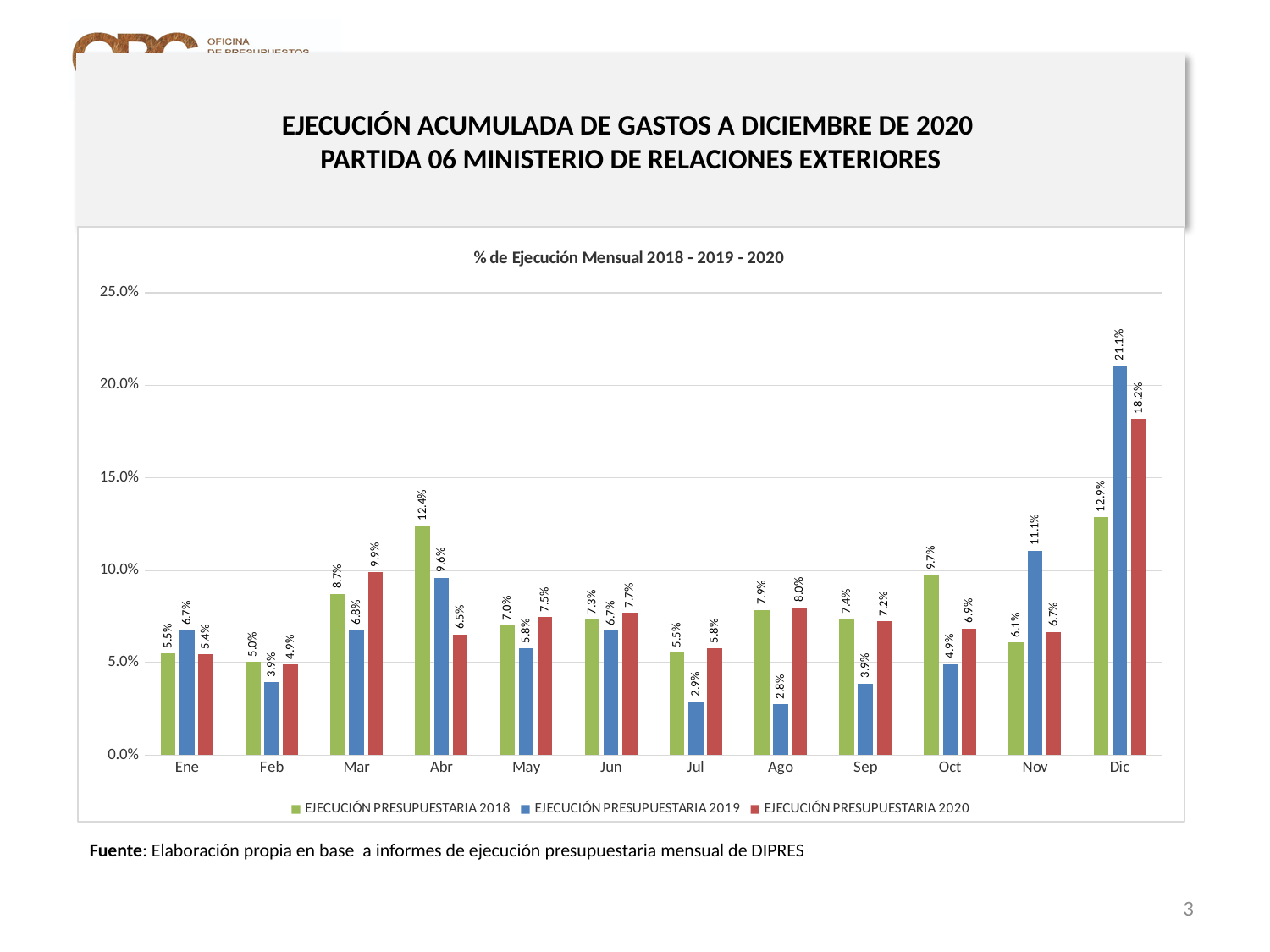
Is the value for EJECUCIÓN PRESUPUESTARIA 2018 in Oct greater or less than 5.0%? greater In Nov, which series has the larger value: EJECUCIÓN PRESUPUESTARIA 2018 or EJECUCIÓN PRESUPUESTARIA 2019? EJECUCIÓN PRESUPUESTARIA 2019 What is the value for EJECUCIÓN PRESUPUESTARIA 2018 in Abr? 12.4% What is the value for EJECUCIÓN PRESUPUESTARIA 2020 in Mar? 9.9% How many months are shown on the x axis of the chart? 12 What is the difference between the EJECUCIÓN PRESUPUESTARIA 2019 and EJECUCIÓN PRESUPUESTARIA 2020 values in Dic? 2.9% How many series does the legend list? 3 Which month has the highest value for EJECUCIÓN PRESUPUESTARIA 2020? Dic What is the title of the chart inside the plot area? % de Ejecución Mensual 2018 - 2019 - 2020 What is the value for EJECUCIÓN PRESUPUESTARIA 2019 in Dic? 21.1% Which month has the lowest value for EJECUCIÓN PRESUPUESTARIA 2019? Ago What kind of chart is shown on the slide? Bar chart